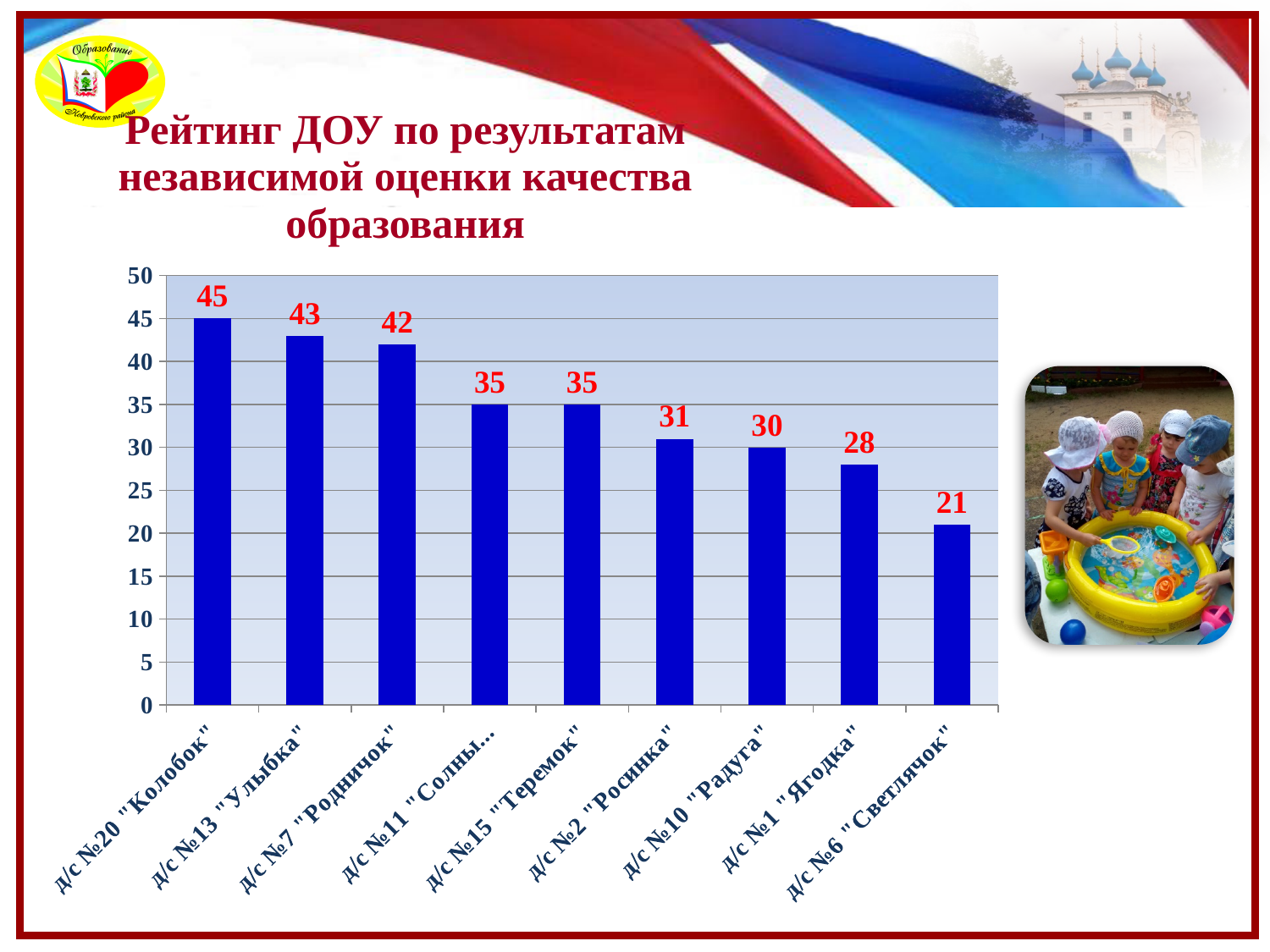
What is the difference between the values for д/с №13 "Улыбка" and д/с №10 "Радуга"? 13 Which is larger, the value for д/с №7 "Родничок" or the value for д/с №15 "Теремок"? д/с №7 "Родничок" What value is shown for д/с №2 "Росинка"? 31 What kind of chart is shown on the slide? bar chart How many categories (bars) are shown in the chart? 9 Which category has the highest value? д/с №20 "Колобок" What value is shown for д/с №20 "Колобок"? 45 What is the maximum value shown on the vertical axis? 50 Is the value for д/с №6 "Светлячок" greater or less than 25? less Which category has the lowest value? д/с №6 "Светлячок" What value is shown for д/с №1 "Ягодка"? 28 Do the values rise or fall from left to right along the x axis? fall